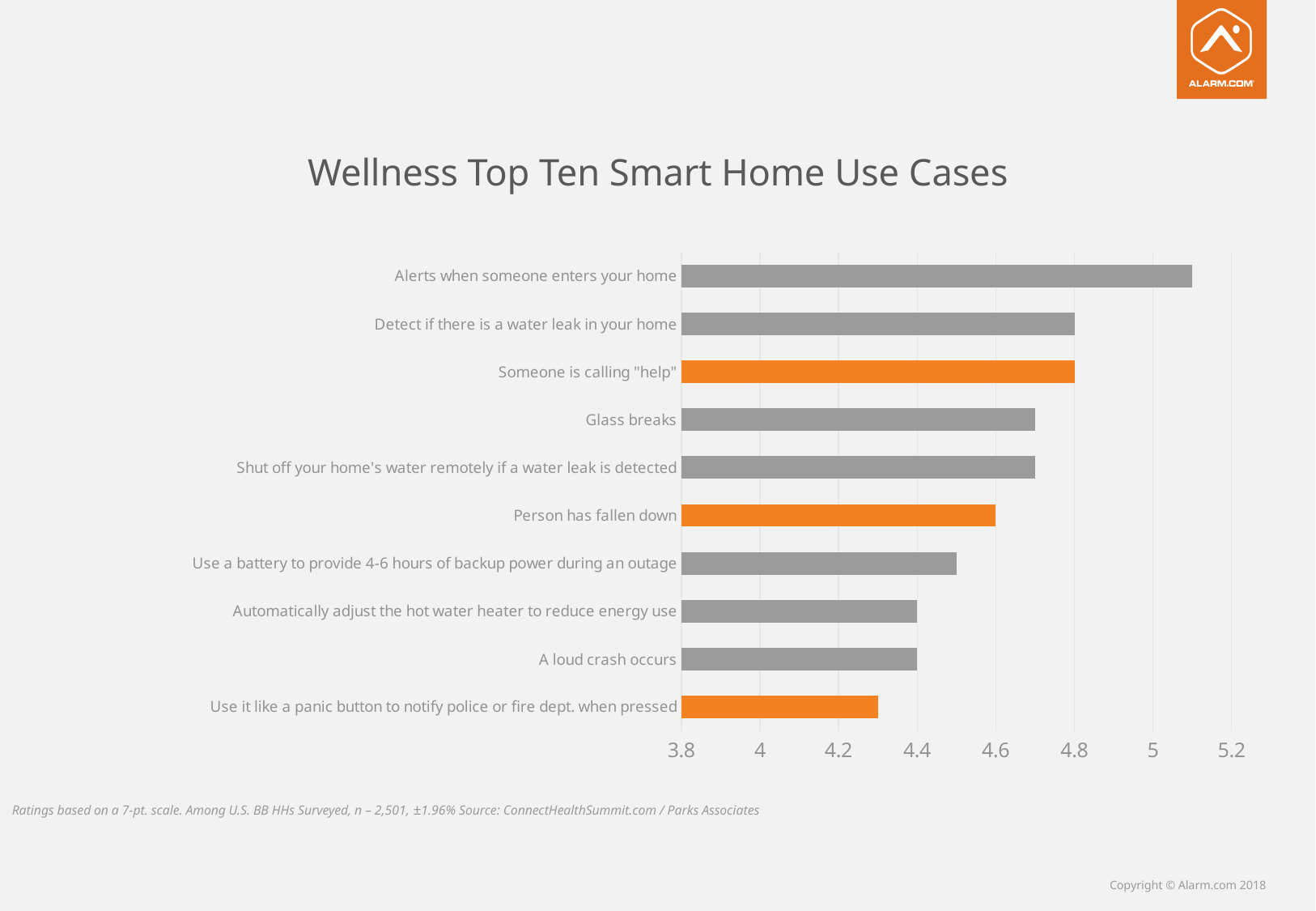
What kind of chart is shown on the slide? bar chart Is the value for "Alerts when someone enters your home" greater or less than 5? greater What is the rating for "Detect if there is a water leak in your home"? 4.8 Which has a higher rating: "Glass breaks" or "Person has fallen down"? Glass breaks What is the rating for "Person has fallen down"? 4.6 What is the title of the chart? Wellness Top Ten Smart Home Use Cases How many use cases are plotted in the chart? 10 Is the value for "Use it like a panic button to notify police or fire dept. when pressed" greater or less than 4.4? less Is the value for "Use a battery to provide 4-6 hours of backup power during an outage" greater or less than 4.6? less What is the rating for "A loud crash occurs"? 4.4 Which use case has the lowest rating in the chart? Use it like a panic button to notify police or fire dept. when pressed Which use case has the highest rating in the chart? Alerts when someone enters your home